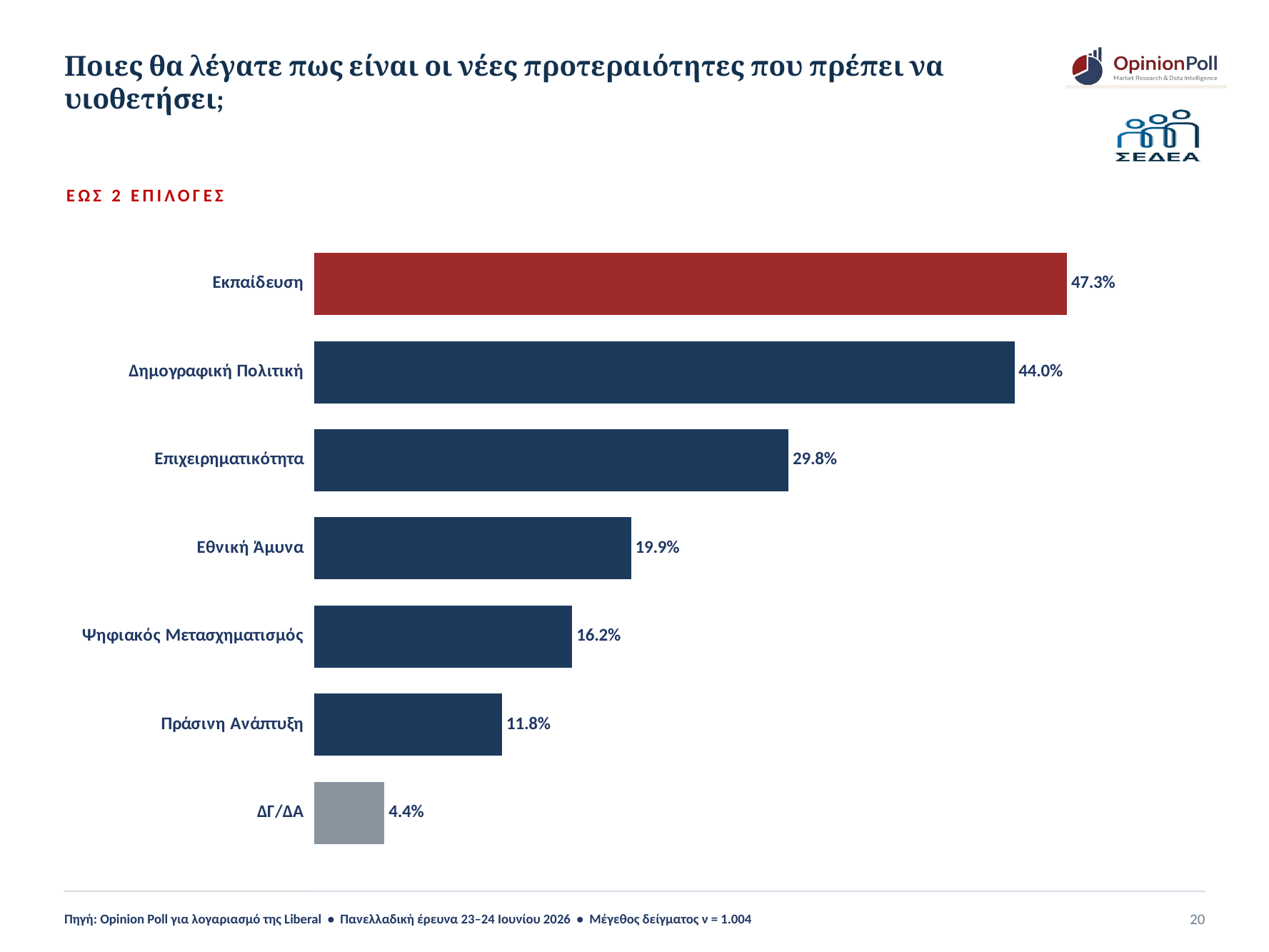
Which category has the highest value? Εκπαίδευση What kind of chart is shown on the slide? Bar chart Which bar is coloured red? Εκπαίδευση What is the difference between Επιχειρηματικότητα and Ψηφιακός Μετασχηματισμός? 13.6% Which category has the lowest value? ΔΓ/ΔΑ What is the value for Εκπαίδευση? 47.3% What is the value for Εθνική Άμυνα? 19.9% Which is larger, Εθνική Άμυνα or Ψηφιακός Μετασχηματισμός? Εθνική Άμυνα How many categories are shown in the chart? 7 What is the value for Πράσινη Ανάπτυξη? 11.8% What is the difference between Εκπαίδευση and Δημογραφική Πολιτική? 3.3% What is the value for Δημογραφική Πολιτική? 44.0%